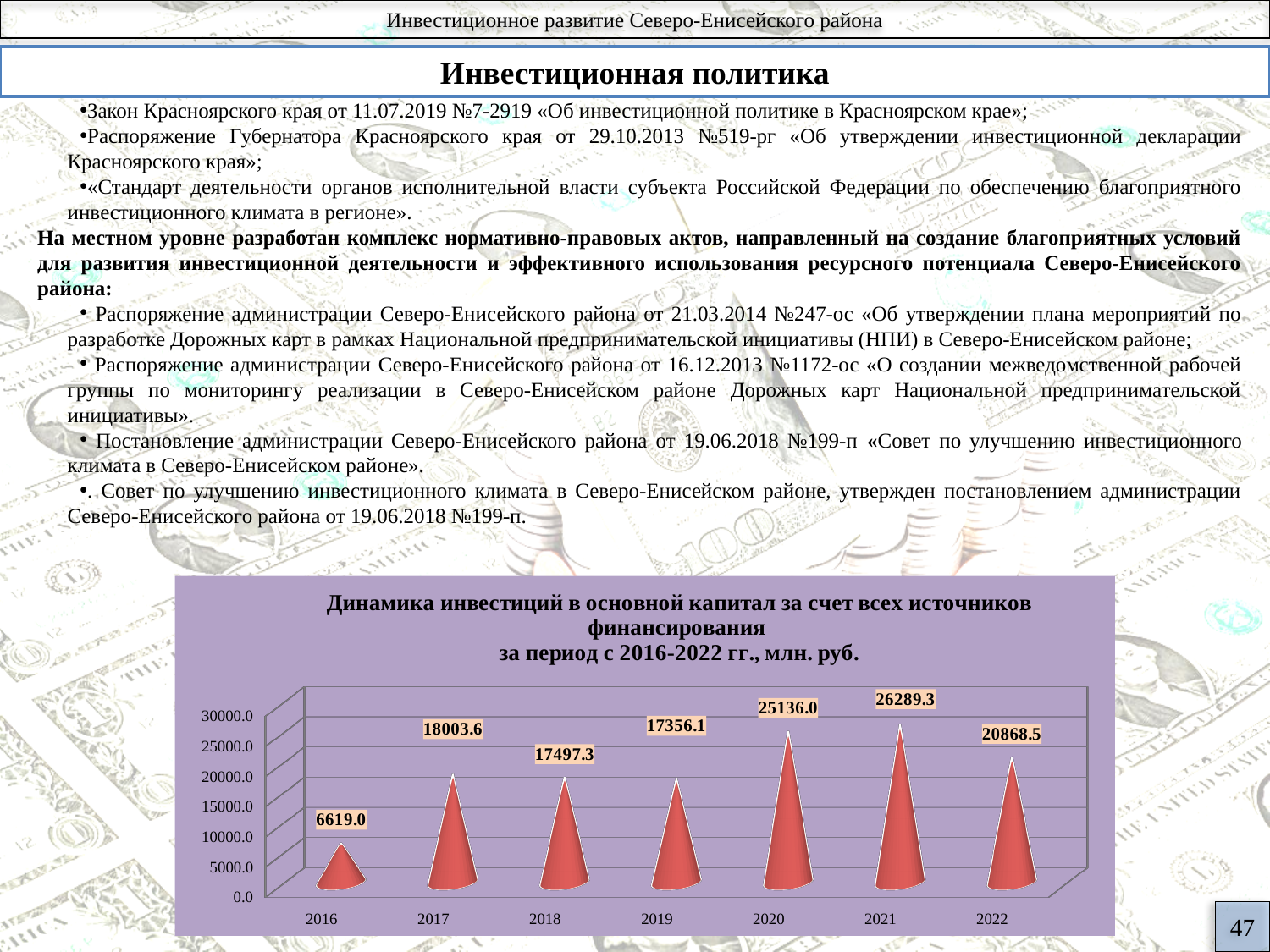
What is the value for 2016 on the chart? 6619.0 Is the value for 2019 greater or less than 20000.0? less What is the value for 2022 on the chart? 20868.5 What kind of chart is shown on the slide? bar chart Which is larger, the value for 2017 or the value for 2022? 2022 Which year has the lowest value on the chart? 2016 In what units are the values on the chart expressed, according to its title? млн. руб. Which year has the highest value on the chart? 2021 What is the difference between the values for 2017 and 2016? 11384.6 What is the value for 2020 on the chart? 25136.0 How many years are shown on the x axis of the chart? 7 What is the difference between the values for 2021 and 2020? 1153.3